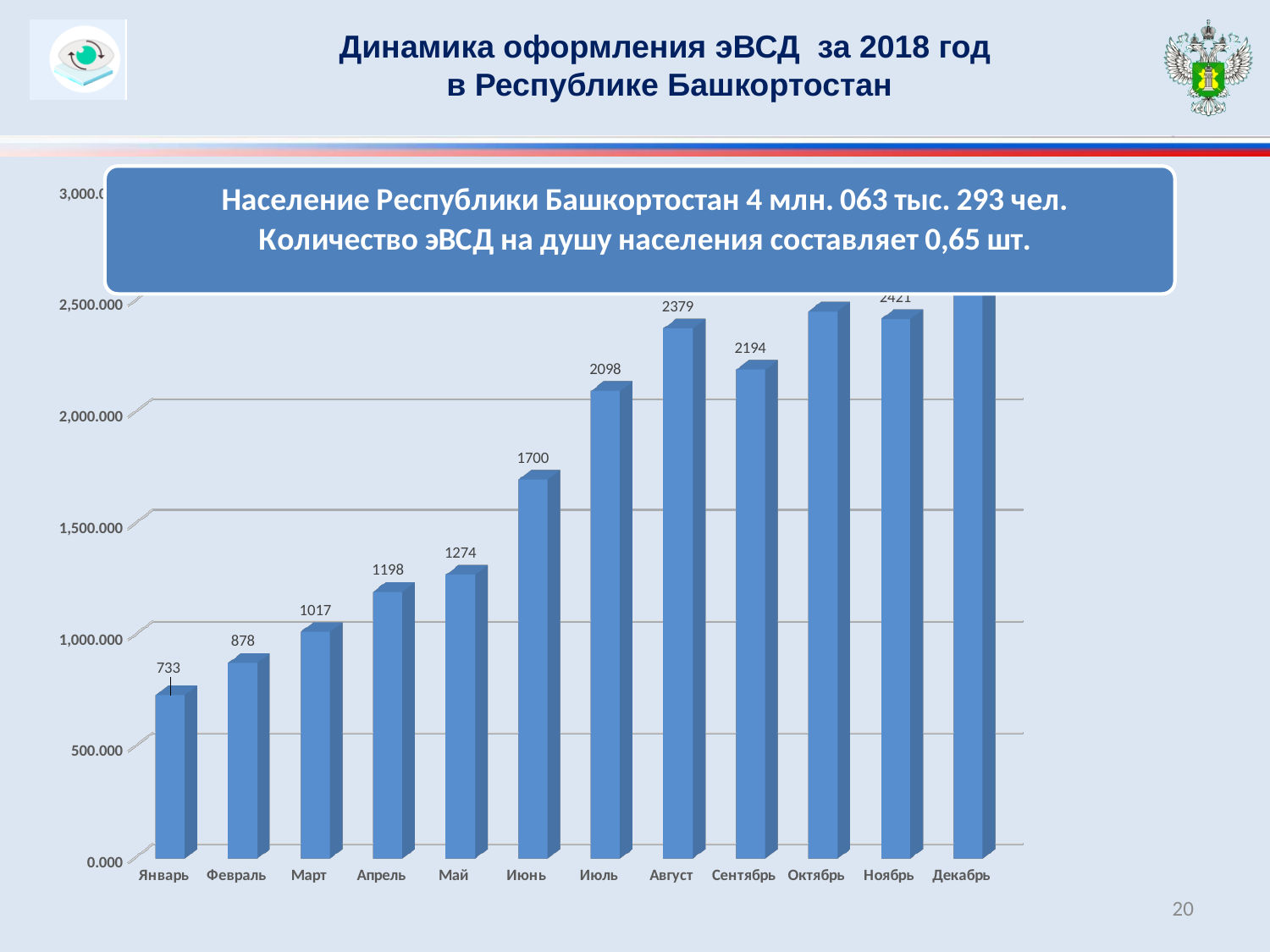
What kind of chart is shown on the slide? bar chart What is the value for Январь? 733 Which month has the lowest value? Январь Which month has the highest bar? Декабрь What is the difference between the values for Июль and Июнь? 398 What is the value for Август? 2379 How many months are shown on the x axis? 12 Do the values generally rise or fall from Январь to Декабрь? rise What is the value for Июнь? 1700 What is the value for Сентябрь? 2194 Is the value for Октябрь greater or less than 2,000.000? greater Which is larger, the value for Август or the value for Сентябрь? Август